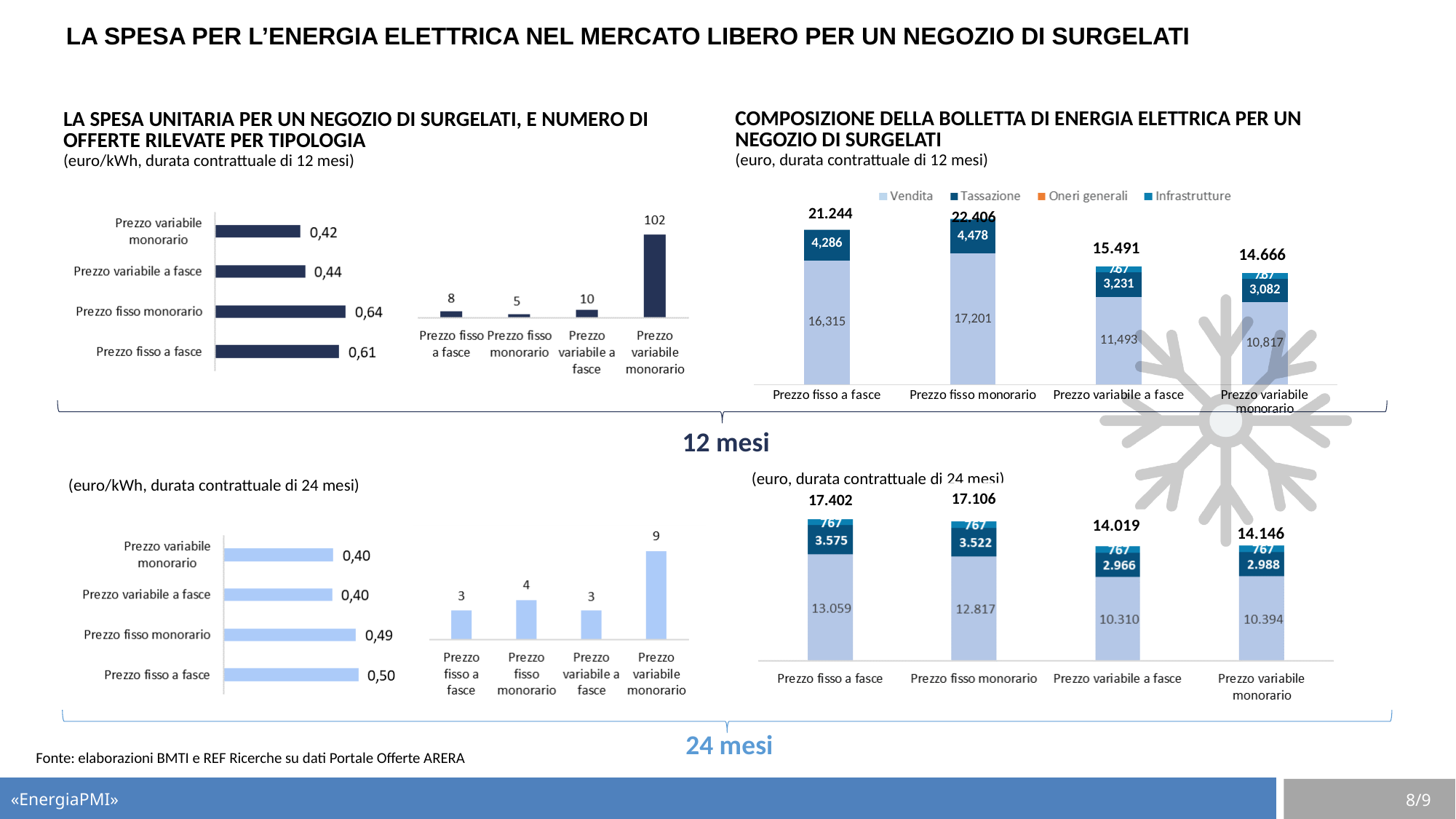
In the top vertical bar chart showing the number of offers for 12 mesi, which category has the lowest value? Prezzo fisso monorario How many series does the legend of the top-right stacked bar chart list? 4 In the top-right stacked bar chart (euro, durata contrattuale di 12 mesi), what is the Vendita value for Prezzo variabile a fasce? 11,493 In the bottom-left horizontal bar chart (euro/kWh, durata contrattuale di 24 mesi), what is the value for Prezzo fisso a fasce? 0,50 In the top-right stacked bar chart (euro, durata contrattuale di 12 mesi), what is the total for Prezzo fisso monorario? 22.406 In the top vertical bar chart showing the number of offers for 12 mesi, what is the value for Prezzo variabile monorario? 102 In the bottom vertical bar chart showing the number of offers for 24 mesi, what is the value for Prezzo fisso monorario? 4 In the top-left horizontal bar chart (euro/kWh, durata contrattuale di 12 mesi), what is the value for Prezzo fisso monorario? 0,64 In the bottom-right stacked bar chart (euro, durata contrattuale di 24 mesi), what is the Tassazione value for Prezzo variabile monorario? 2.988 In the bottom-right stacked bar chart (euro, durata contrattuale di 24 mesi), which category has the highest total? Prezzo fisso a fasce In the top-left horizontal bar chart (euro/kWh, durata contrattuale di 12 mesi), which category has the lowest value? Prezzo variabile monorario In the top-left horizontal bar chart (euro/kWh, durata contrattuale di 12 mesi), what is the difference between Prezzo fisso monorario and Prezzo fisso a fasce? 0,03